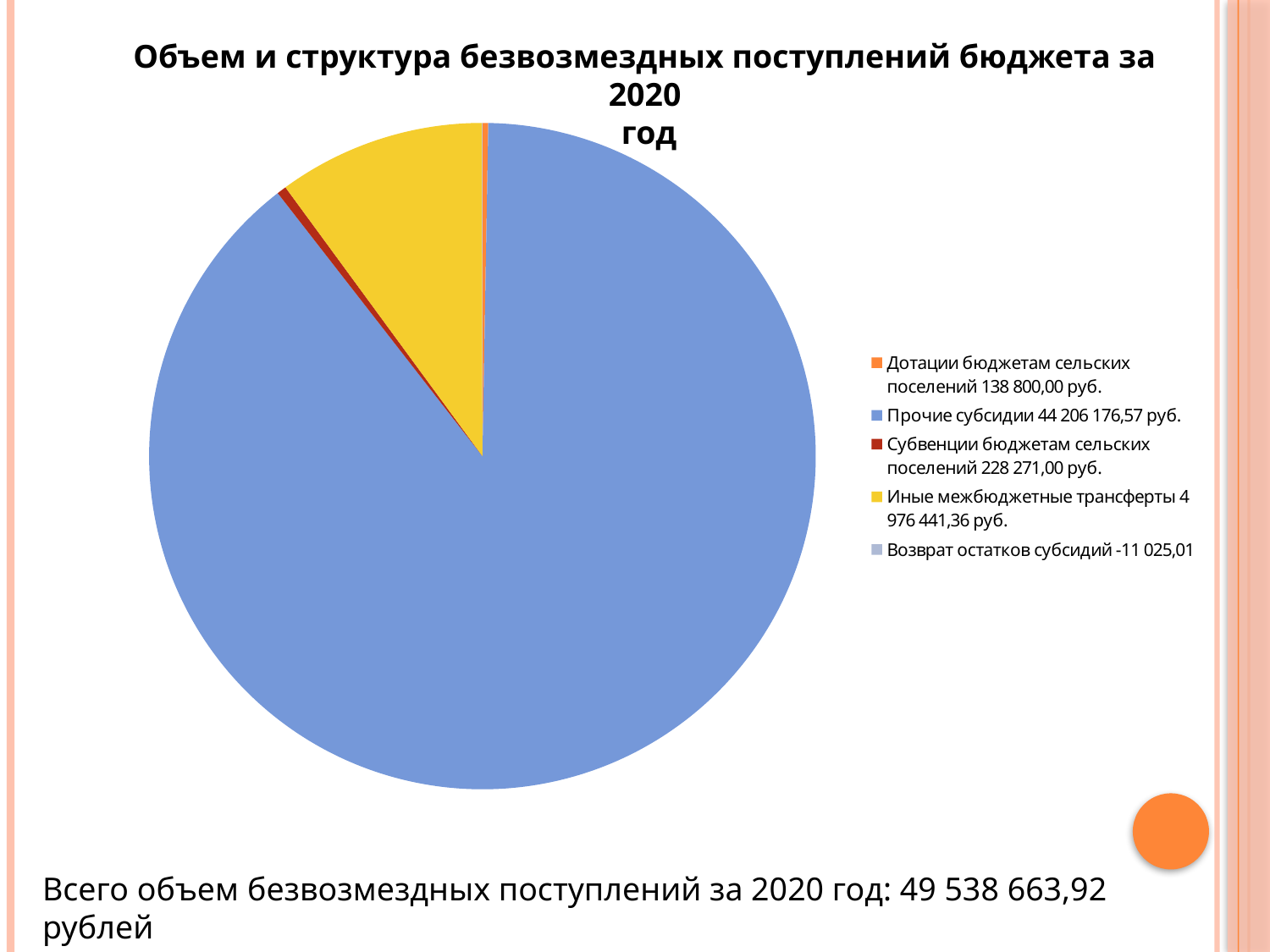
What is the value for Субвенции бюджетам сельских поселений? 228 271,00 руб. What is the value for Возврат остатков субсидий? -11 025,01 How many categories does the legend list? 5 What is the value for Иные межбюджетные трансферты? 4 976 441,36 руб. What colour is the slice for Иные межбюджетные трансферты? Yellow What is the value for Прочие субсидии? 44 206 176,57 руб. What is the value for Дотации бюджетам сельских поселений? 138 800,00 руб. Which is larger: Субвенции бюджетам сельских поселений or Дотации бюджетам сельских поселений? Субвенции бюджетам сельских поселений What kind of chart is shown on the slide? Pie chart Which category has the largest value in the pie chart? Прочие субсидии According to the text below the chart, what is the total volume of gratuitous receipts for 2020? 49 538 663,92 рублей What is the difference between Субвенции бюджетам сельских поселений and Дотации бюджетам сельских поселений? 89 471,00 руб.